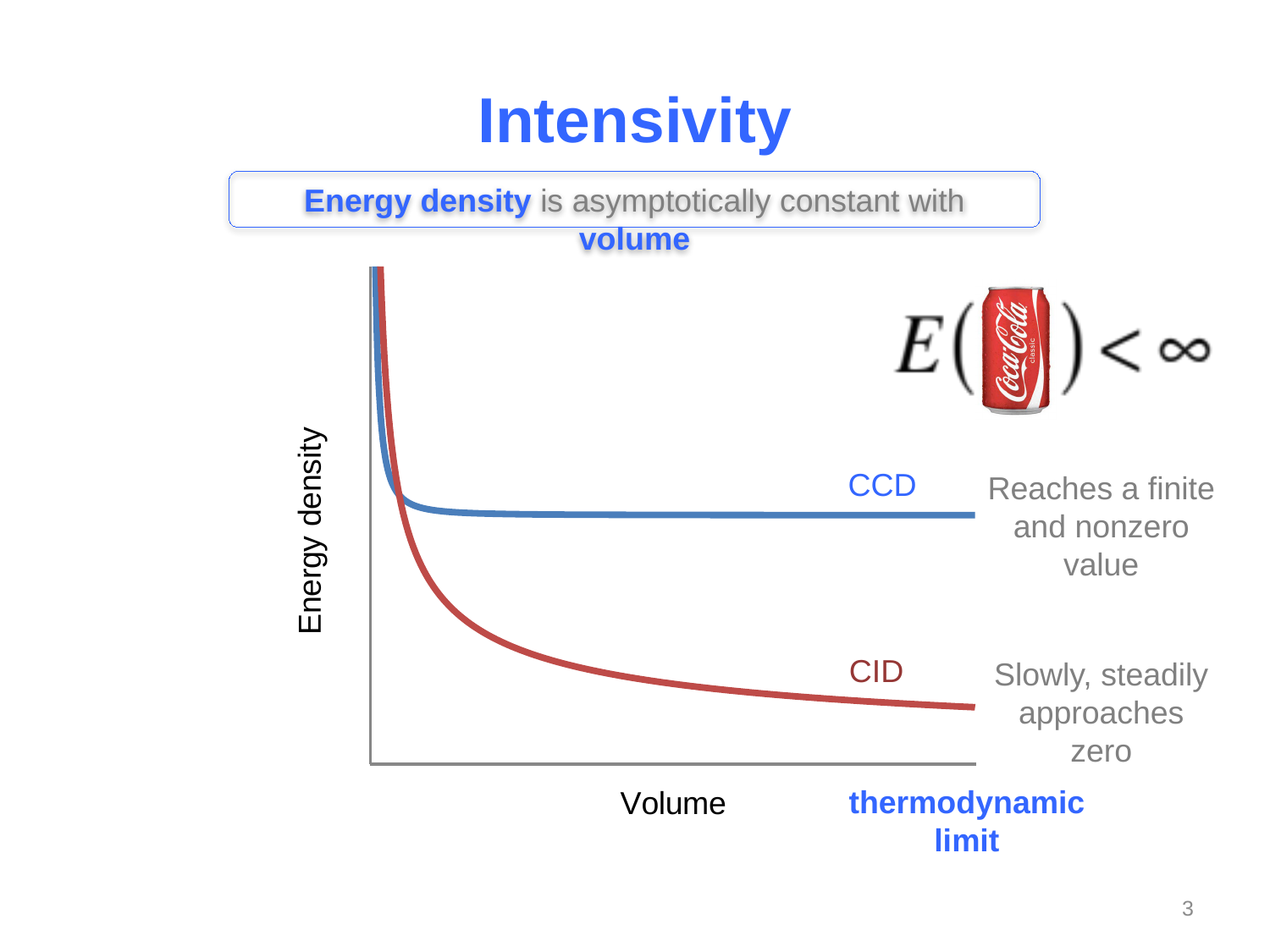
According to the chart annotation, which curve slowly, steadily approaches zero? CID What is the label of the x axis of the chart? Volume Does the CID curve rise or fall as volume increases? fall What are the labels of the two curves plotted on the chart? CCD and CID At large volume (the right end of the chart), which curve has the lower energy density, CCD or CID? CID How many curves (series) are plotted on the chart? 2 Does the CCD curve rise or fall as volume increases? fall At large volume (the right end of the chart), which curve has the higher energy density, CCD or CID? CCD What is the label of the y axis of the chart? Energy density According to the chart annotation, which curve reaches a finite and nonzero value? CCD What kind of chart is shown on the slide? line chart